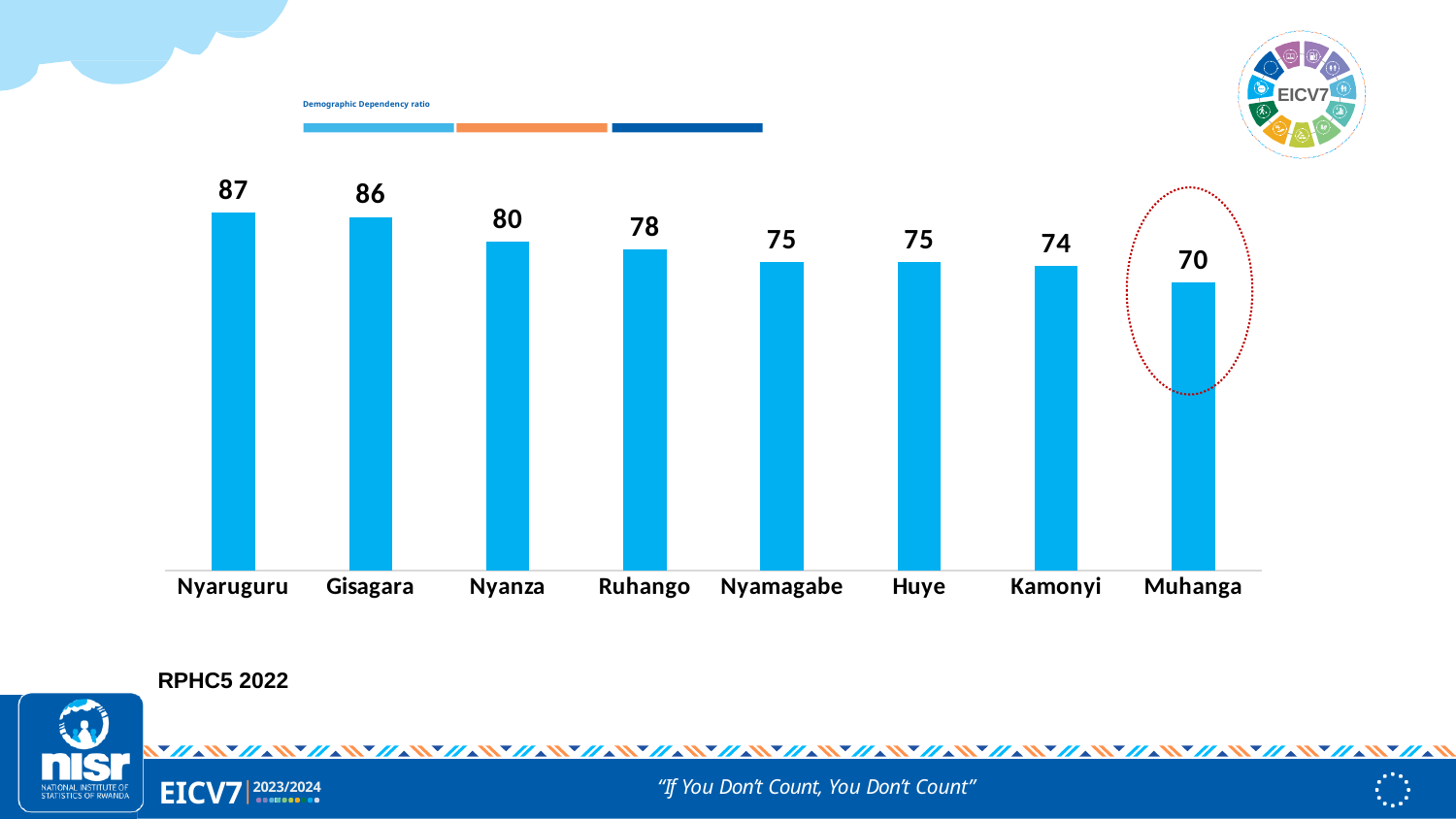
What is the difference between the values for Gisagara and Ruhango? 8 Which has a higher value, Nyanza or Kamonyi? Nyanza What is the difference between the values for Nyaruguru and Muhanga? 17 What is the value shown for Nyanza? 80 What is the demographic dependency ratio for Nyaruguru? 87 Which district has the lowest demographic dependency ratio? Muhanga What is the demographic dependency ratio for Muhanga? 70 What is the value shown for Kamonyi? 74 How many districts are shown on the chart? 8 Do the values rise or fall from left to right across the districts? Fall Which district has the highest demographic dependency ratio? Nyaruguru What kind of chart is shown on the slide? Bar chart